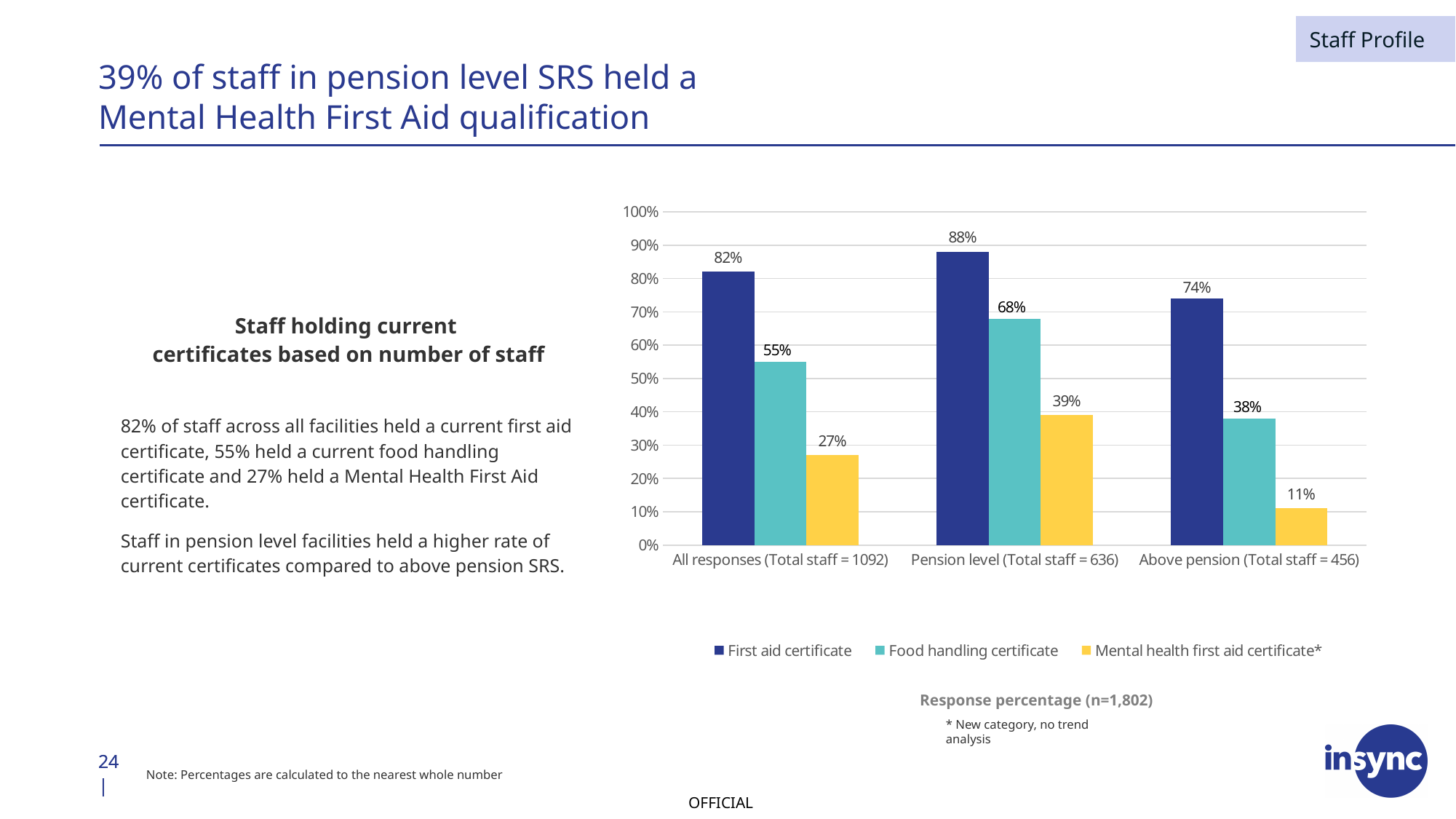
Which is larger: the food handling certificate value for 'All responses' or for 'Above pension'? All responses Which group has the lowest value for the mental health first aid certificate? Above pension (Total staff = 456) What is the value for the food handling certificate in the 'Pension level' group? 68% What is the difference between the food handling certificate and mental health first aid certificate values in the 'Pension level' group? 29% What percentage of staff in the 'Above pension' group held a mental health first aid certificate? 11% Which legend entry is marked with an asterisk? Mental health first aid certificate* What percentage of staff in the 'All responses' group held a current first aid certificate? 82% What kind of chart is shown on the slide? Bar chart How many groups are shown on the x axis of the chart? 3 How many series does the legend list? 3 What is the difference between the first aid certificate values for 'Pension level' and 'Above pension'? 14% Which group has the highest value for the first aid certificate? Pension level (Total staff = 636)